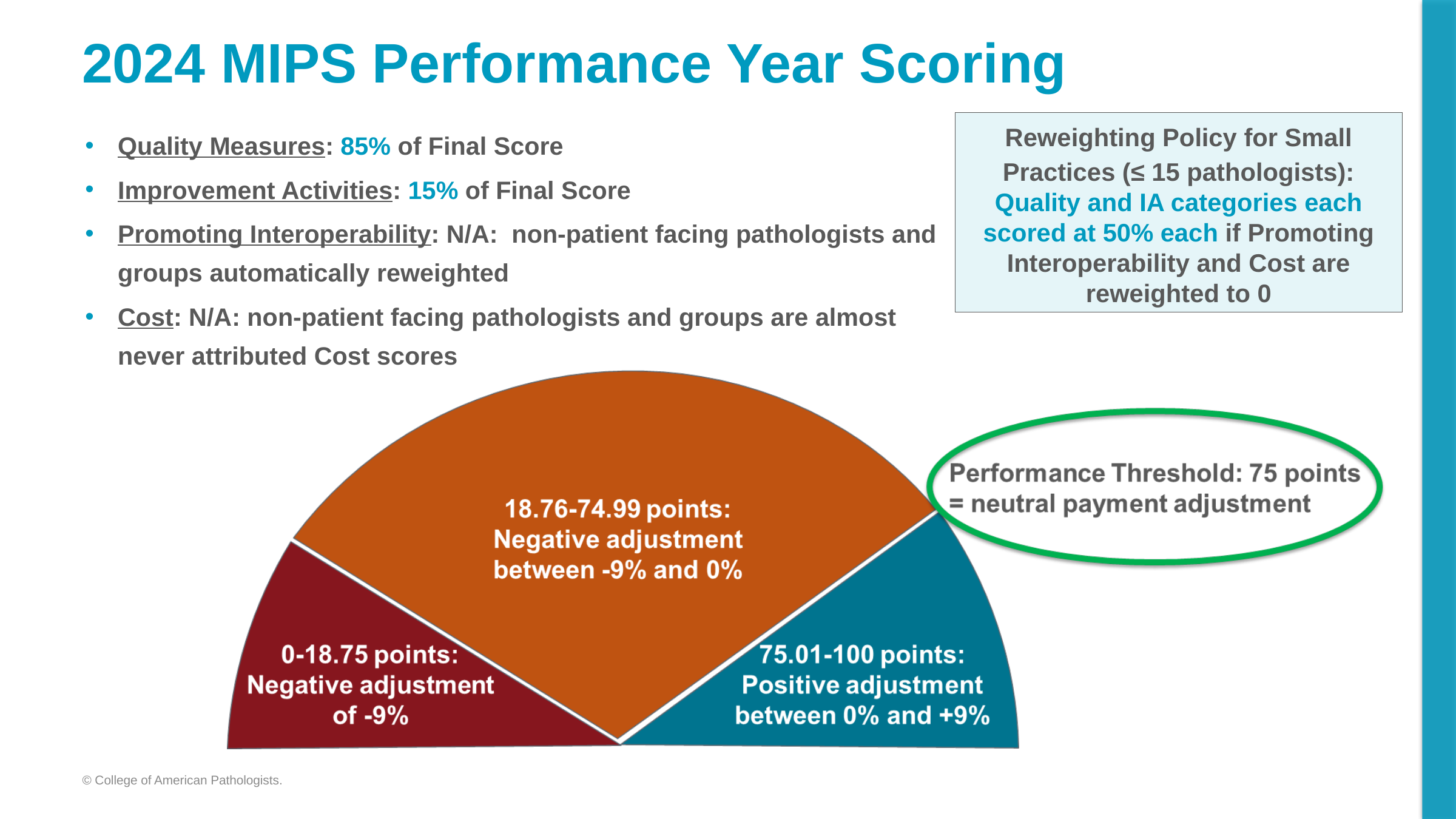
What point range is shown on the dark red segment of the gauge chart? 0-18.75 points What colour is the segment for 0-18.75 points? Dark red How many segments does the semicircular gauge chart have? 3 What colour is the segment for 75.01-100 points? Blue Which segment of the gauge chart is the largest? 18.76-74.99 points What payment adjustment applies to the 18.76-74.99 points segment? Negative adjustment between -9% and 0% What point range is shown on the orange segment of the gauge chart? 18.76-74.99 points Which segment is larger, the 0-18.75 points segment or the 75.01-100 points segment? 75.01-100 points What performance threshold is shown in the green oval next to the gauge chart? 75 points What payment adjustment applies to the 0-18.75 points segment? Negative adjustment of -9% What point range is shown on the blue segment of the gauge chart? 75.01-100 points What payment adjustment applies to the 75.01-100 points segment? Positive adjustment between 0% and +9%